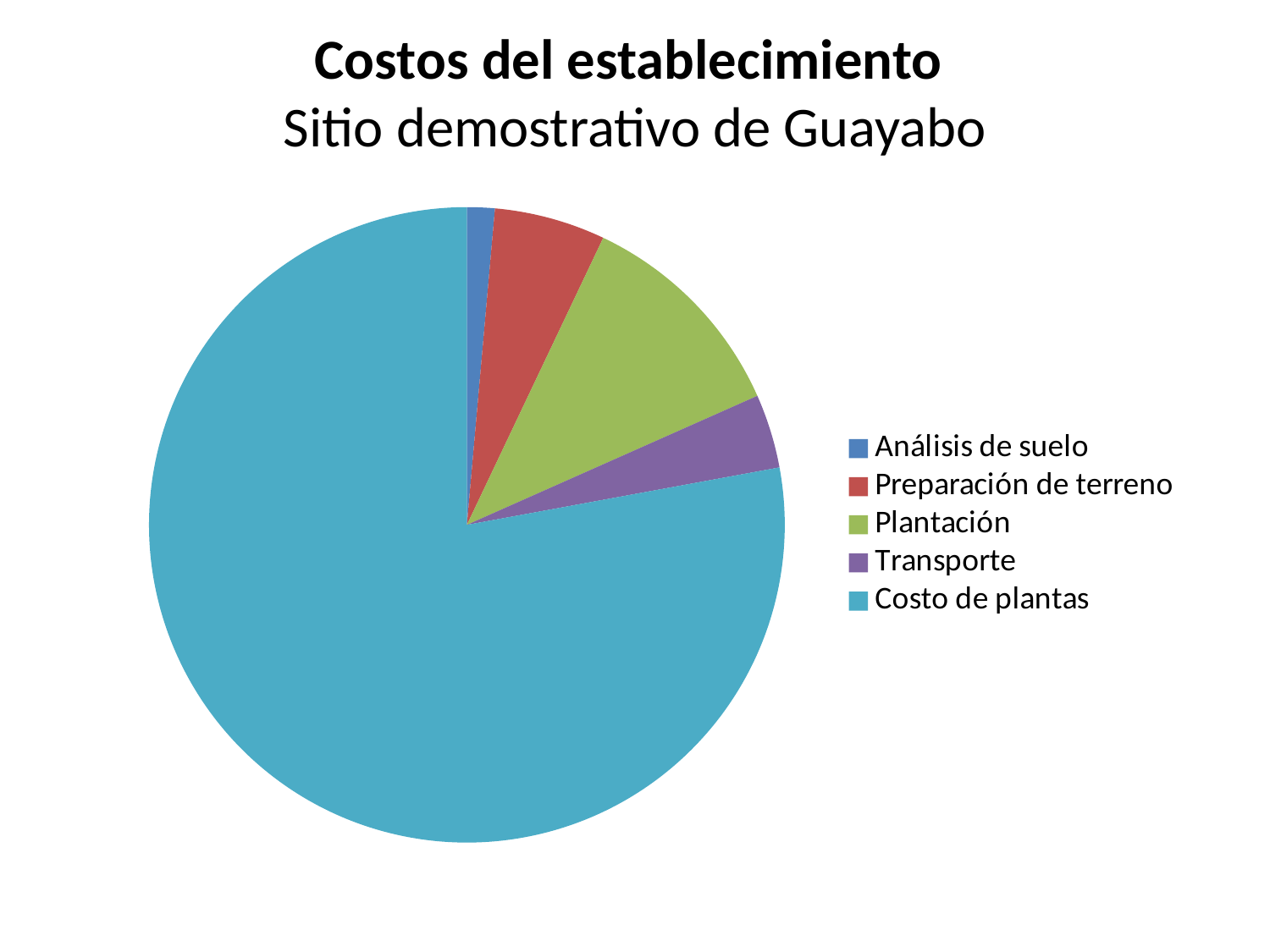
What kind of chart is shown on the slide? pie chart How many slices does the pie chart have? 5 Which slice is larger, Plantación or Transporte? Plantación Which category has the largest slice of the pie? Costo de plantas Is the Costo de plantas slice greater or less than half of the pie? greater How many entries does the legend list? 5 Which slice is larger, Costo de plantas or Plantación? Costo de plantas What is the title of the chart? Costos del establecimiento Sitio demostrativo de Guayabo What colour is the Plantación slice? green Which category has the smallest slice of the pie? Análisis de suelo Which slice is larger, Plantación or Preparación de terreno? Plantación